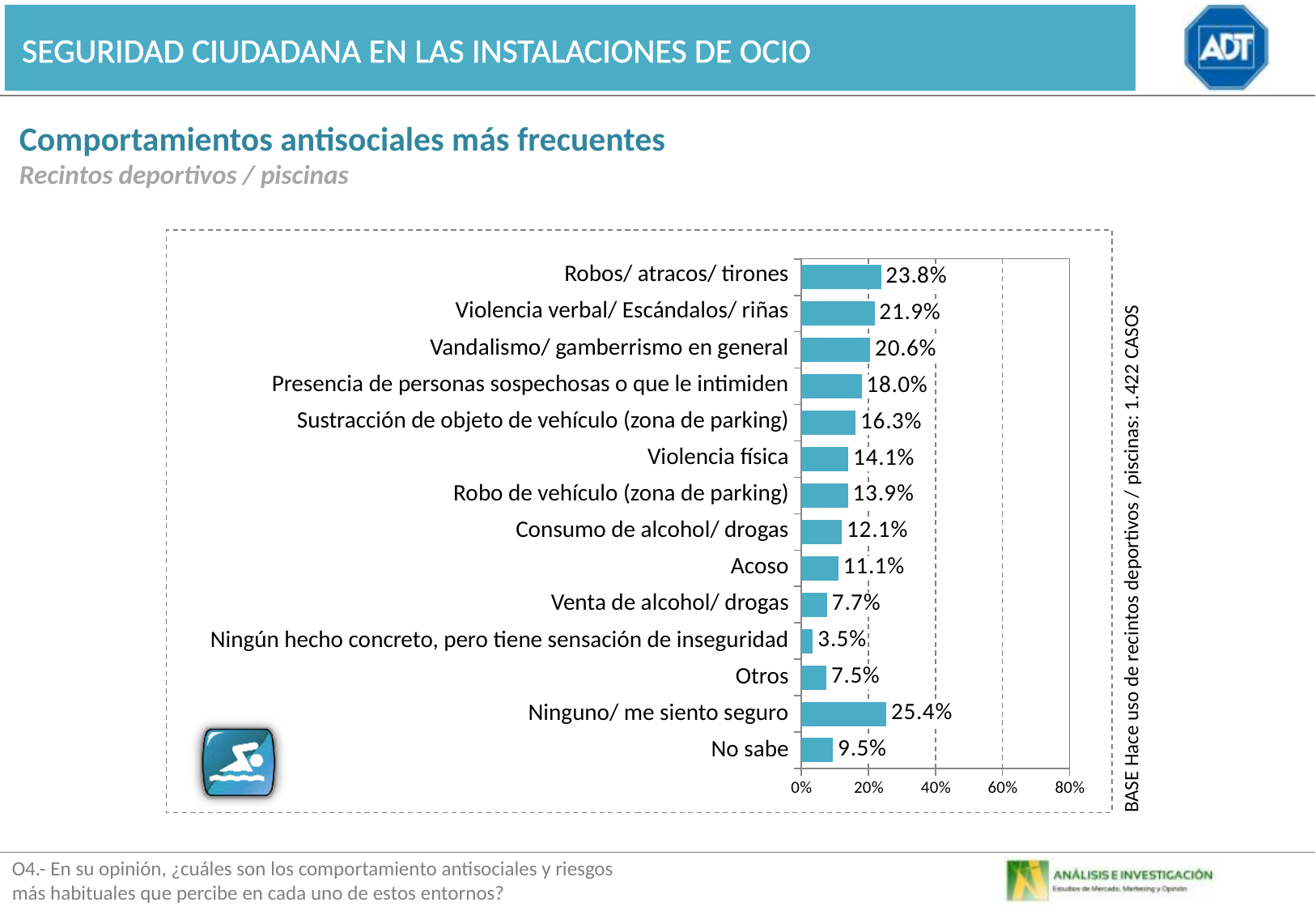
What is the value for "No sabe"? 9.5% How many categories are shown in the chart? 14 Which category has the highest value? Ninguno/ me siento seguro What is the value for "Ninguno/ me siento seguro"? 25.4% Which category has the lowest value? Ningún hecho concreto, pero tiene sensación de inseguridad What is the difference between "Robos/ atracos/ tirones" and "Violencia verbal/ Escándalos/ riñas"? 1.9% What is the subtitle shown under the chart title "Comportamientos antisociales más frecuentes"? Recintos deportivos / piscinas What kind of chart is shown on the slide? bar chart What is the value for "Robos/ atracos/ tirones"? 23.8% Which is larger, "Consumo de alcohol/ drogas" or "Acoso"? Consumo de alcohol/ drogas Is the value for "Vandalismo/ gamberrismo en general" greater or less than 40%? less What is the value for "Violencia física"? 14.1%